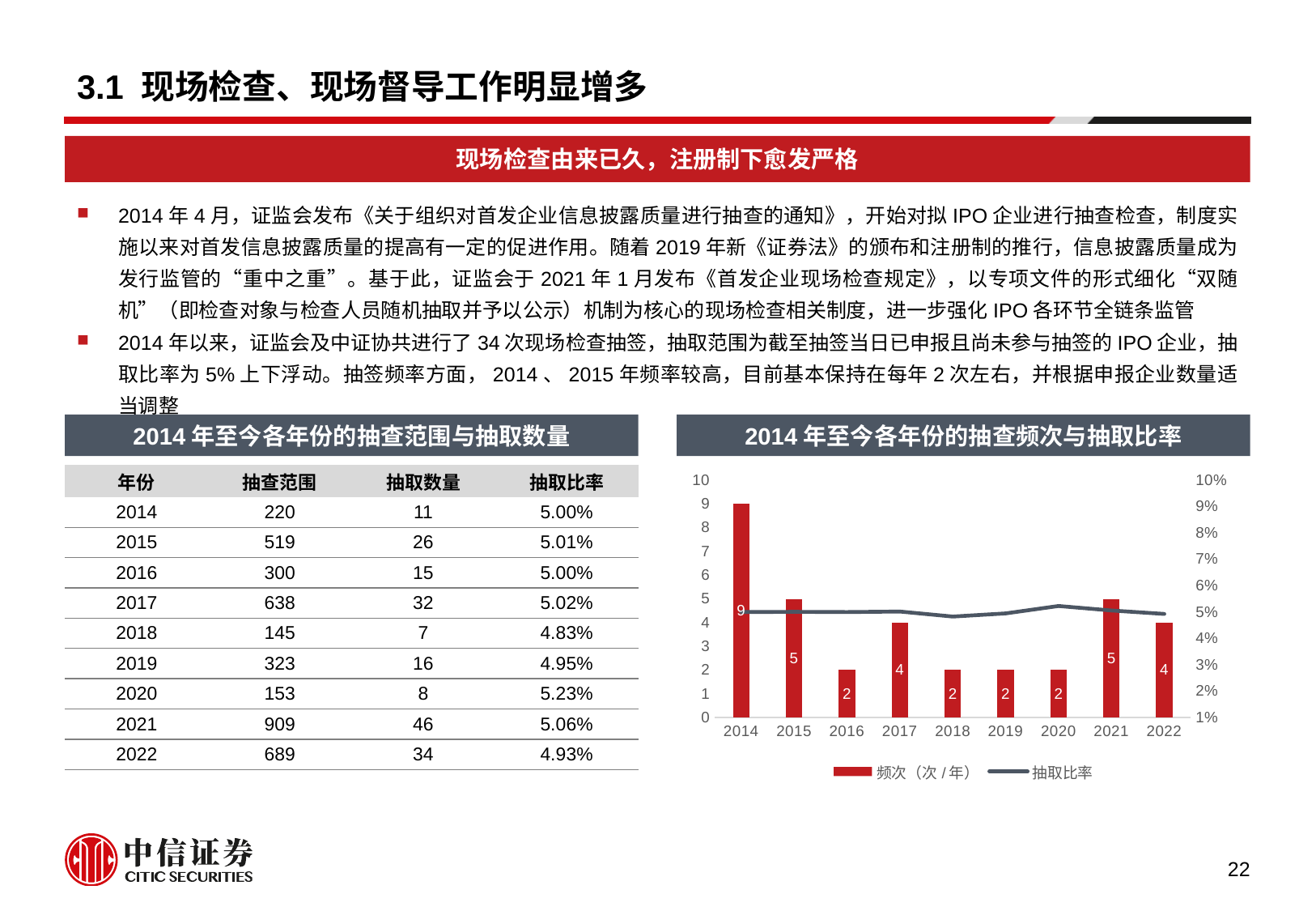
Which year has the highest 频次 in the chart? 2014 What is the difference between the 频次 values for 2014 and 2015? 4 How many series does the chart legend list? 2 What kind of chart is used to show 频次 in the chart? bar chart What is the 频次 value for 2014 in the chart? 9 Do the 频次 bars rise or fall from 2014 to 2016? fall Which year has a higher 频次, 2015 or 2022? 2015 What is the title of the chart on the slide? 2014年至今各年份的抽查频次与抽取比率 What is the lowest 频次 value shown in the chart? 2 What is the 频次 value for 2017 in the chart? 4 How many years are shown on the x axis of the chart? 9 What is the 频次 value for 2021 in the chart? 5